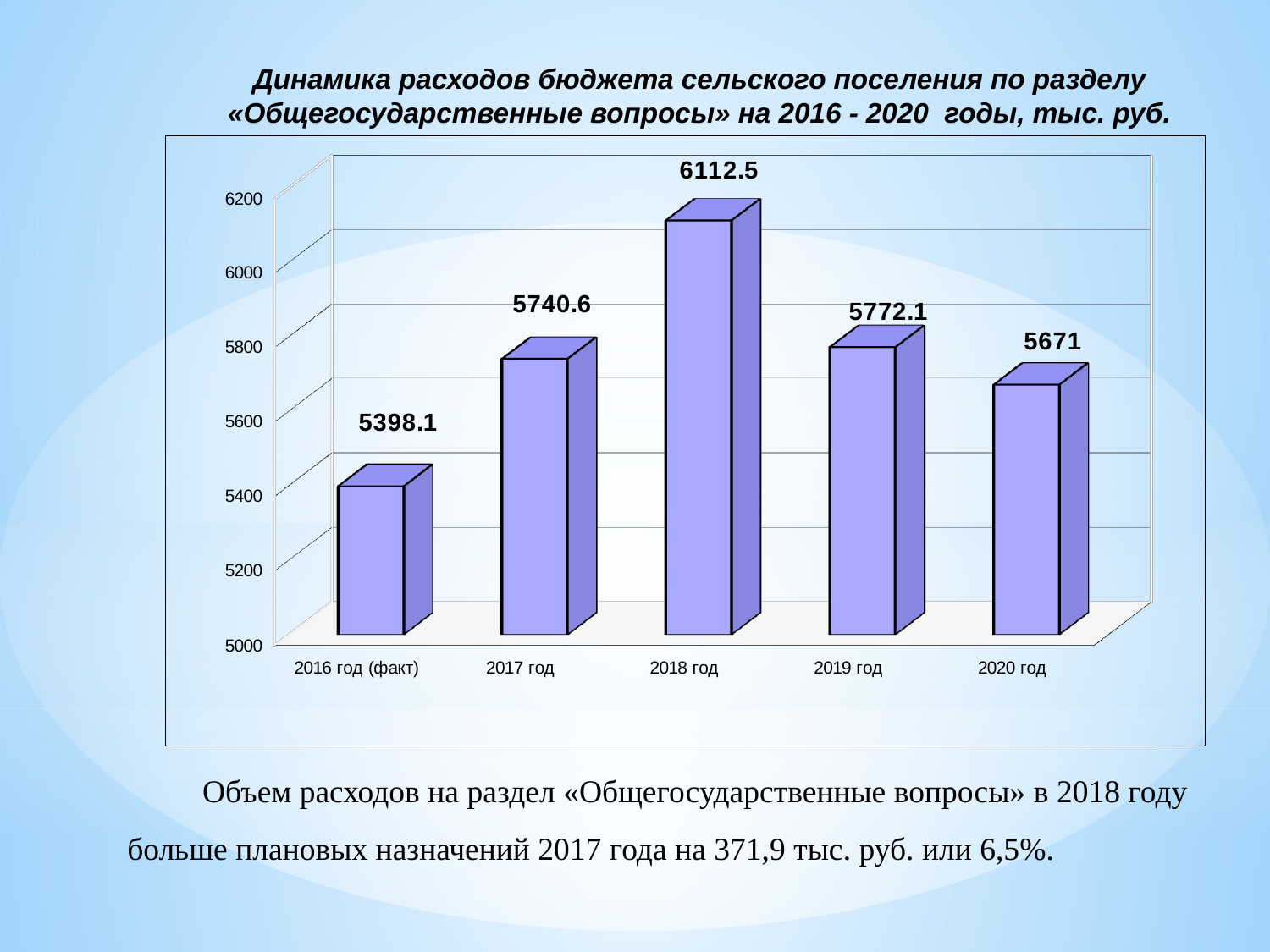
Which is larger, the value for 2017 год or the value for 2019 год? 2019 год What is the difference between the values for 2019 год and 2020 год? 101.1 What kind of chart is shown on the slide? bar chart Is the value for 2020 год greater or less than 5800? less What is the value for 2020 год? 5671 What is the value for 2018 год? 6112.5 What is the value for 2016 год (факт)? 5398.1 How many years are shown on the chart? 5 What is the difference between the values for 2018 год and 2017 год? 371.9 Which year has the highest value? 2018 год Do the values rise or fall from 2016 год (факт) to 2018 год? rise Which year has the lowest value? 2016 год (факт)